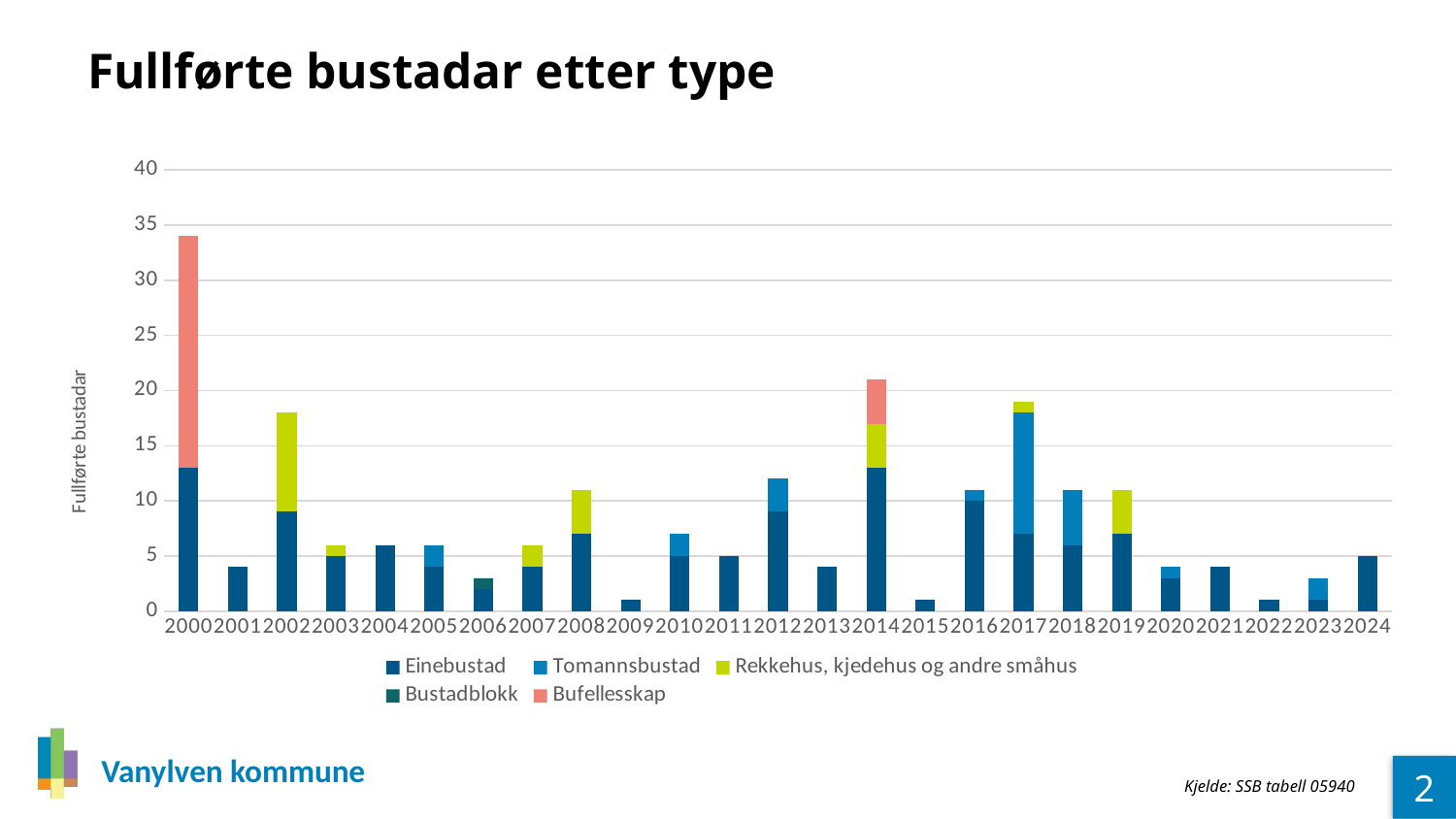
Is the total for 2002 greater or less than 20? less Is the total for 2000 greater or less than 30? greater Is the total for 2009 greater or less than 5? less Which year has the highest total of completed dwellings? 2000 What is the title of the chart? Fullførte bustadar etter type What kind of chart is shown on the slide? Stacked bar chart How many years are shown on the x axis? 25 In which year does the Bustadblokk series appear? 2006 Which year has the larger total, 2012 or 2013? 2012 How many series does the legend list? 5 Which year has the larger total, 2000 or 2014? 2000